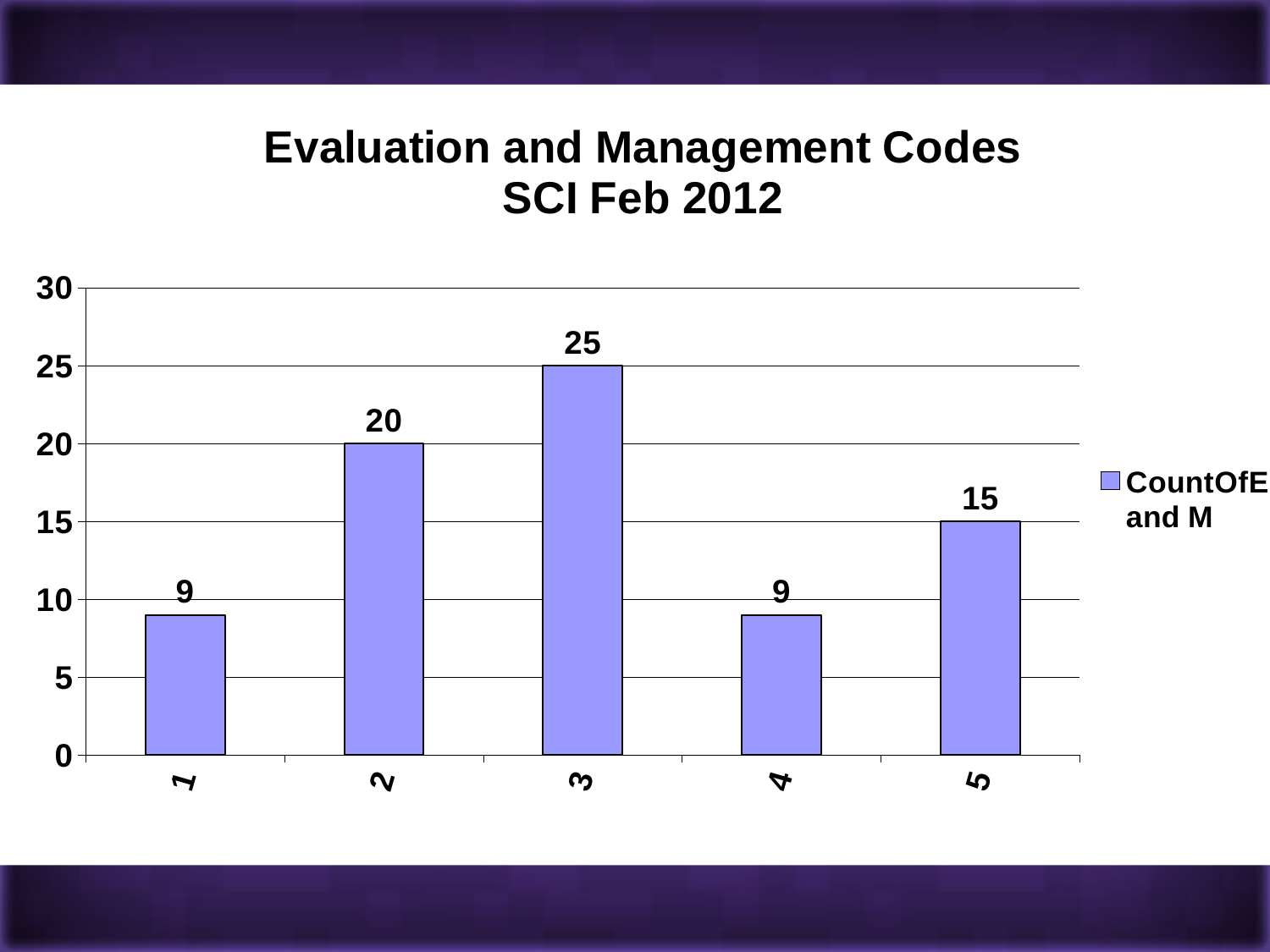
What kind of chart is shown on the slide? bar chart What is the difference between the values for category 3 and category 2? 5 What is the value for category 3? 25 Is the value for category 4 greater or less than 10? less How many categories are shown on the x axis? 5 What is the value for category 2? 20 What is the title of the chart? Evaluation and Management Codes SCI Feb 2012 How many series does the legend list? 1 What is the value for category 5? 15 Which category has the highest value? 3 What is the difference between the values for category 5 and category 1? 6 Which is larger, the value for category 2 or the value for category 5? 2